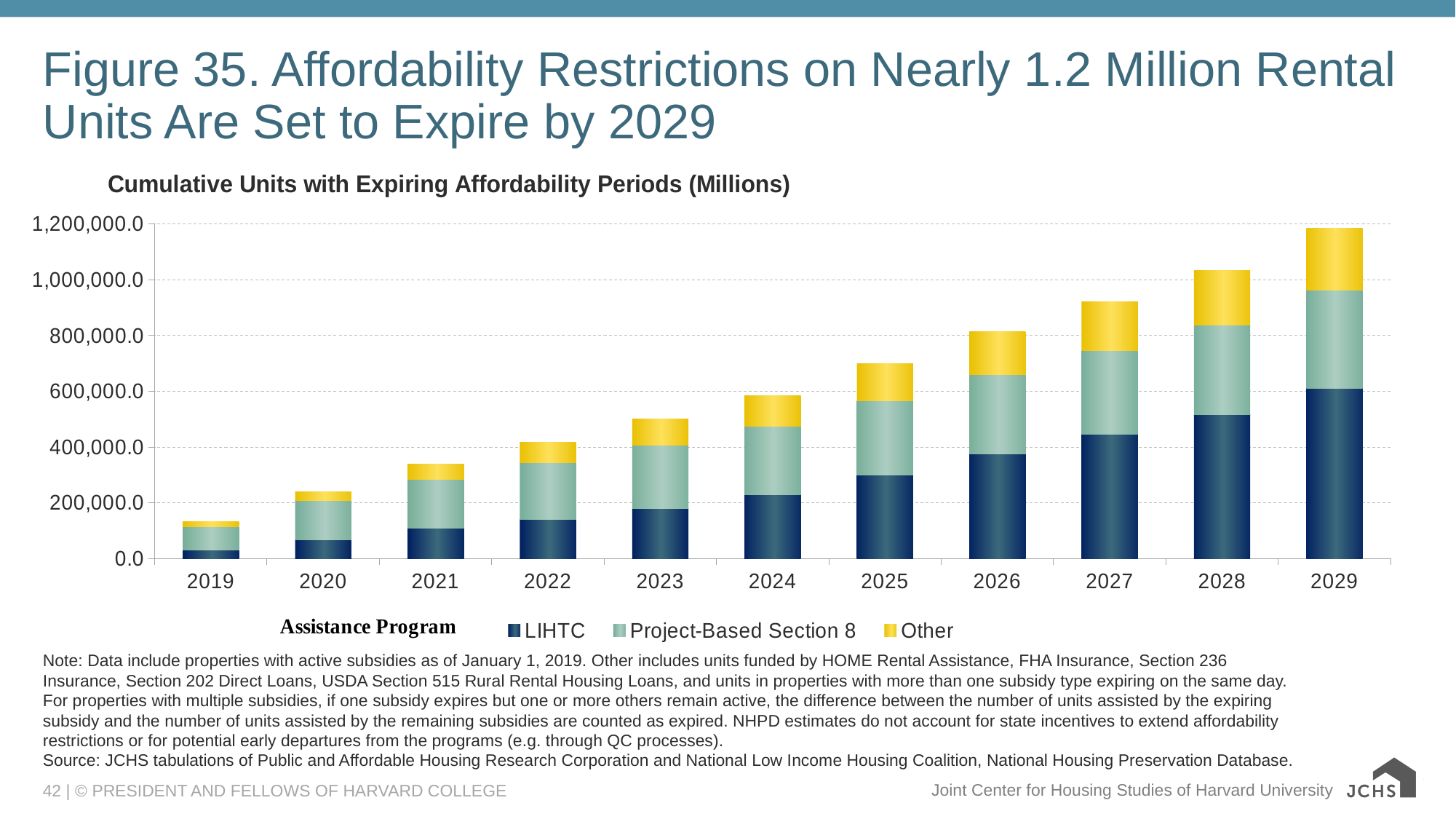
What is the title of the chart's axis label shown above the plot area? Cumulative Units with Expiring Affordability Periods (Millions) Is the total value for 2029 greater or less than 1,000,000.0? greater In 2029, which series accounts for more units: LIHTC or Other? LIHTC Is the LIHTC value for 2028 greater or less than 400,000.0? greater Which year has the highest total of cumulative units with expiring affordability periods? 2029 How many series does the chart's legend list? 3 Is the total value for 2019 greater or less than 200,000.0? less What kind of chart is shown on the slide? Stacked bar chart Which year has the lowest total of cumulative units with expiring affordability periods? 2019 Do the total bar heights rise or fall from 2019 to 2029? Rise How many years are shown along the x axis of the chart? 11